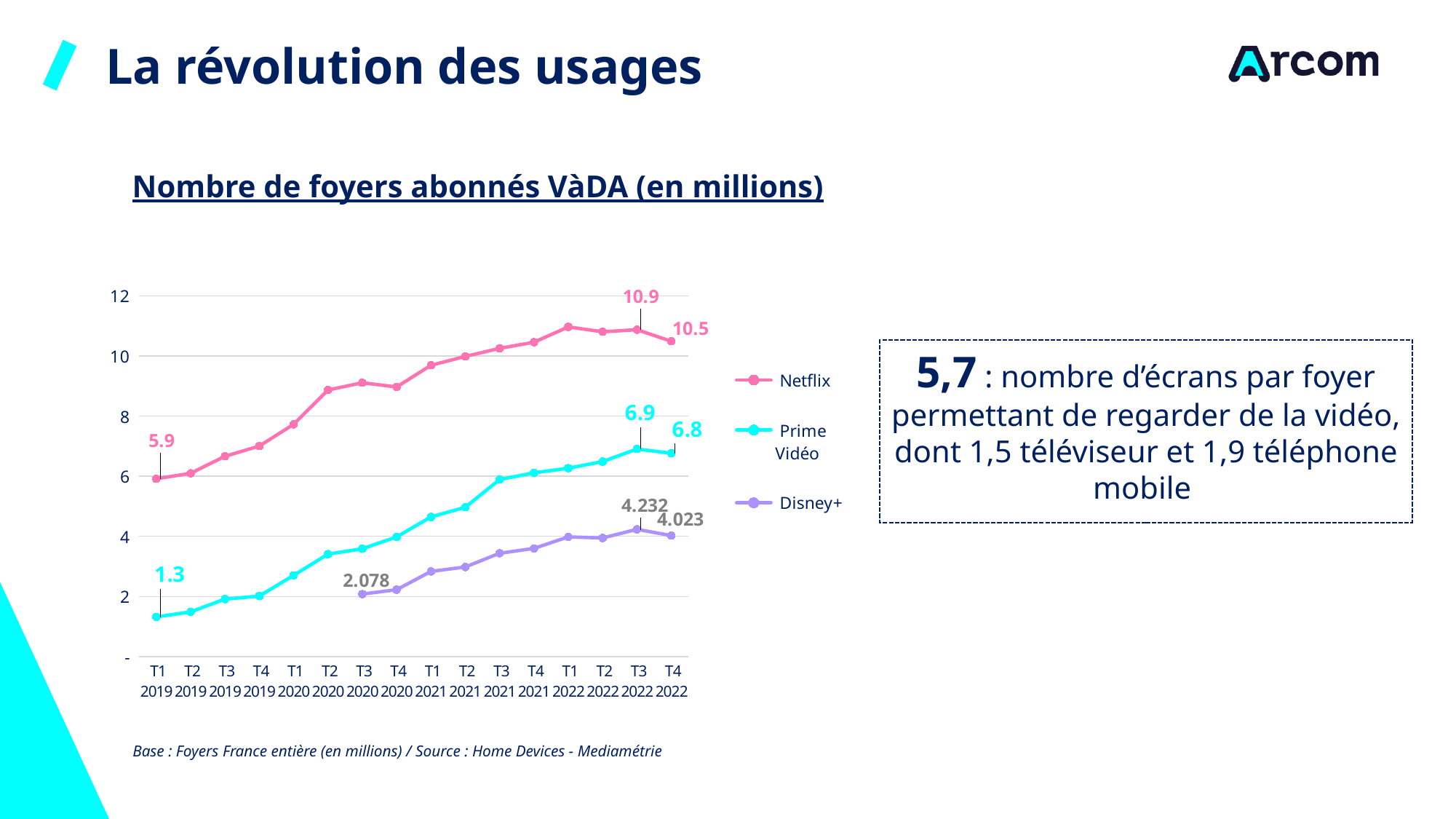
Does the Prime Vidéo series generally rise or fall from T1 2019 to T3 2022? rise Which series has the highest value in T4 2022? Netflix Is the value for Prime Vidéo in T1 2019 greater or less than 2? less What is the value for Disney+ in T3 2020? 2.078 What is the difference between the Netflix values in T3 2022 and T4 2022? 0.4 What is the value for Disney+ in T4 2022? 4.023 What type of chart is shown on the slide? line chart How many series does the legend list? 3 What is the value for Netflix in T3 2022? 10.9 What is the value for Netflix in T1 2019? 5.9 How many quarters are shown on the x axis? 16 What is the value for Prime Vidéo in T4 2022? 6.8